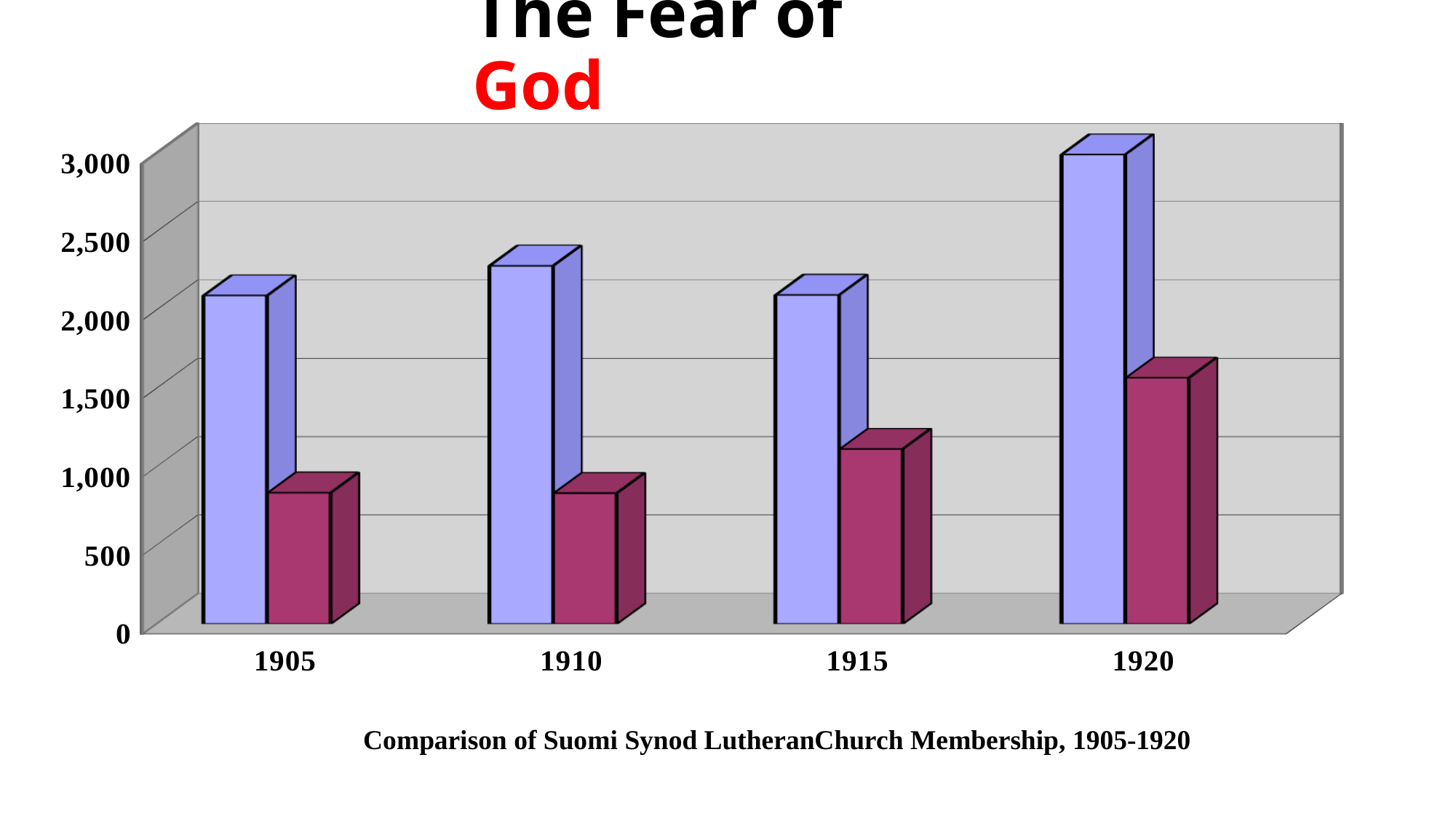
Is the value of the magenta bar for 1905 greater or less than 1,000? less In which year is the blue bar the tallest? 1920 How many bars are plotted for each year in the chart? 2 Which is larger, the magenta bar for 1920 or the magenta bar for 1905? 1920 Which is larger, the blue bar for 1920 or the blue bar for 1910? 1920 Is the value of the blue bar for 1910 greater or less than 2,000? greater Is the value of the magenta bar for 1920 greater or less than 1,000? greater What is the caption/title printed below the chart? Comparison of Suomi Synod LutheranChurch Membership, 1905-1920 What kind of chart is shown on the slide? bar chart In which year is the magenta bar the tallest? 1920 How many years are shown on the x axis of the chart? 4